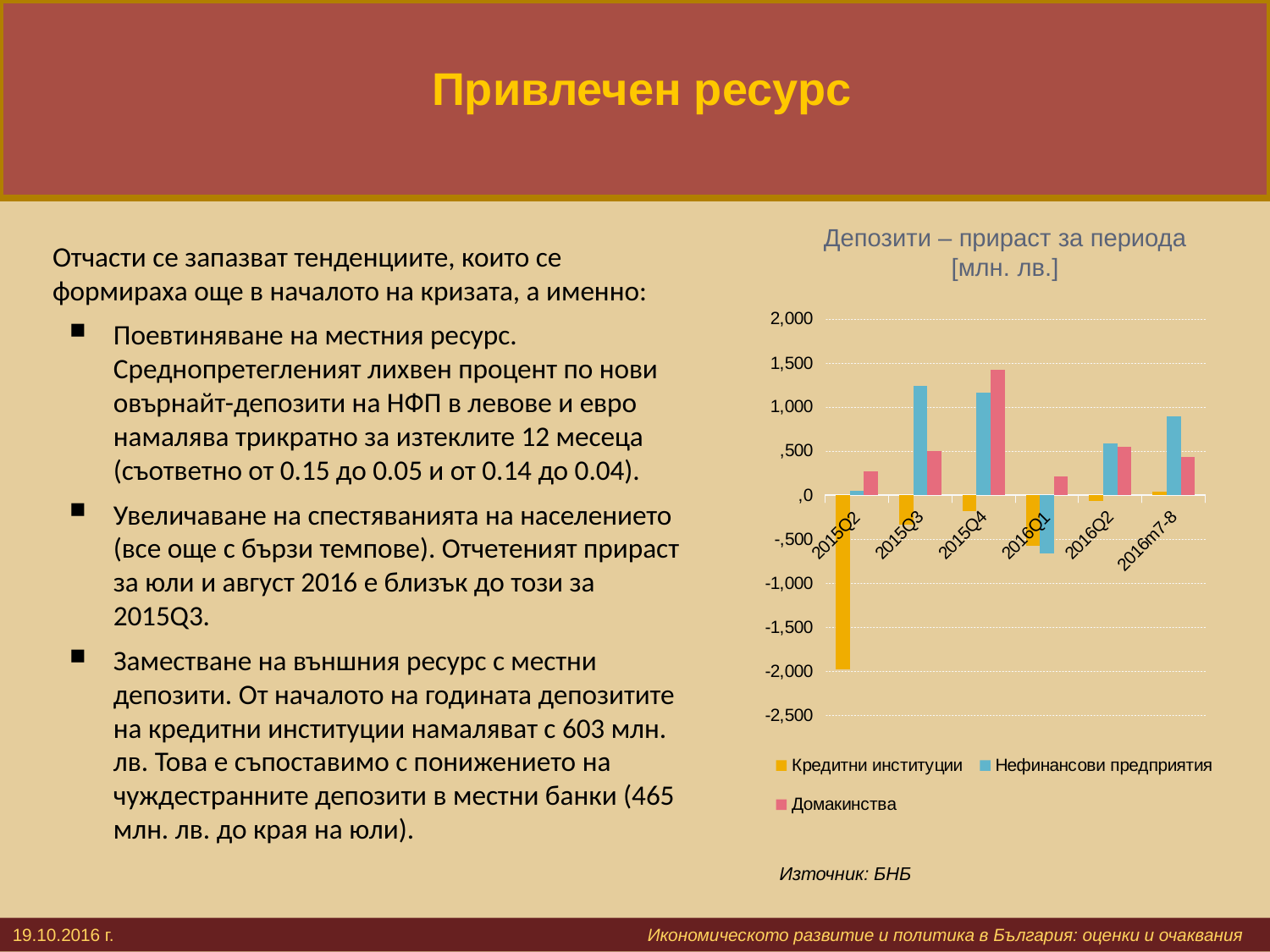
How many periods are shown on the x axis of the chart? 6 In 2015Q3, which is larger: the value for Нефинансови предприятия or the value for Домакинства? Нефинансови предприятия Is the value for Кредитни институции in 2015Q2 greater or less than -1,500? less Is the value for Нефинансови предприятия in 2016m7-8 greater or less than 500? greater How many series does the legend of the chart list? 3 What kind of chart is shown on the slide? bar chart What is the title of the chart? Депозити – прираст за периода [млн. лв.] In which period is the value for Кредитни институции the lowest? 2015Q2 In which period is the value for Домакинства the highest? 2015Q4 Is the value for Нефинансови предприятия in 2015Q3 greater or less than 1,000? greater What source is cited below the chart? БНБ